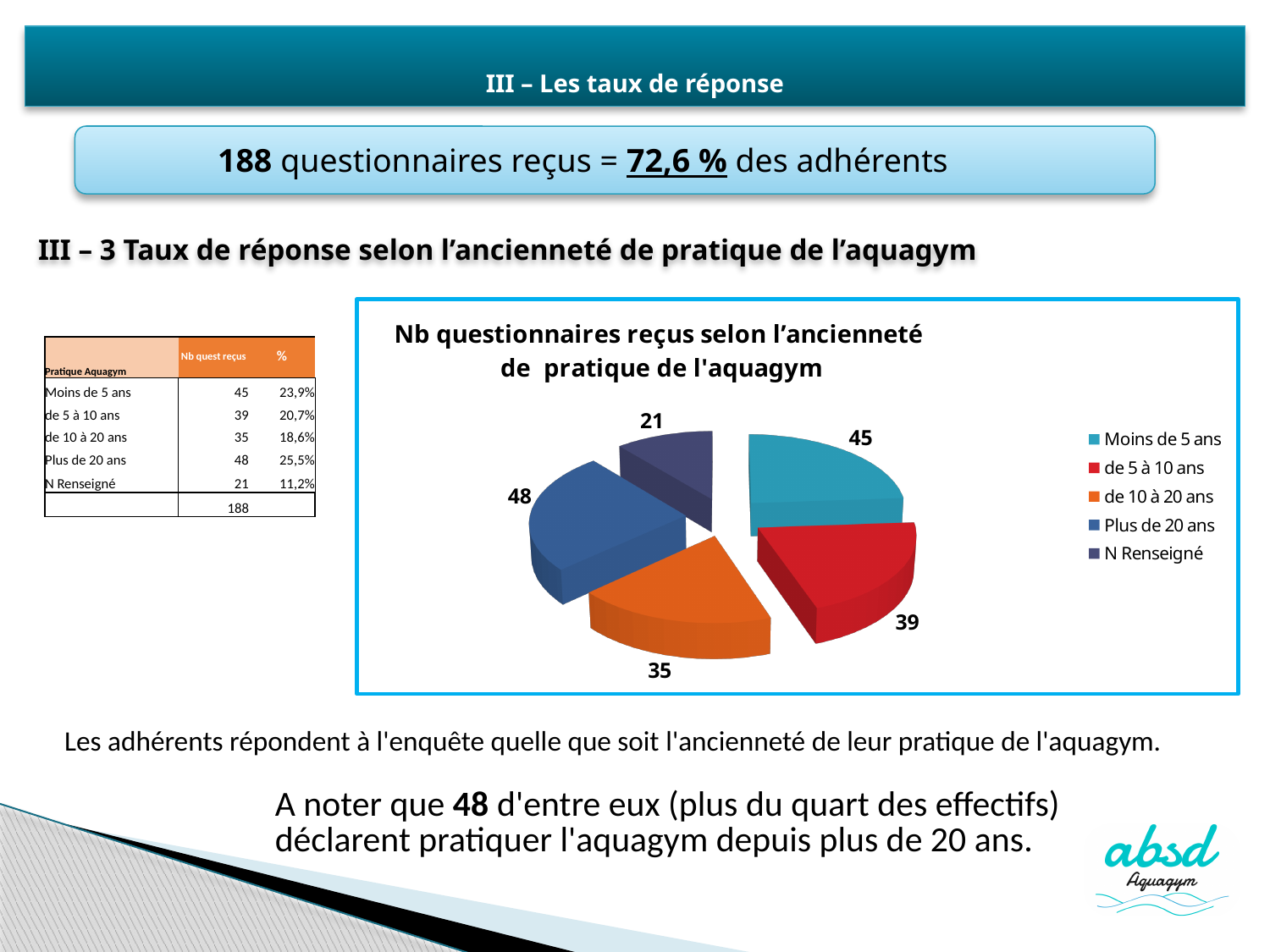
What is the value for 'Moins de 5 ans' in the pie chart? 45 What is the total of all the values shown in the pie chart? 188 Which category has the smallest slice in the pie chart? N Renseigné What kind of chart is shown on the slide? pie chart How many entries does the legend of the pie chart list? 5 How many slices does the pie chart have? 5 What is the value for 'N Renseigné' in the pie chart? 21 What is the title of the pie chart? Nb questionnaires reçus selon l'ancienneté de pratique de l'aquagym Which category has the largest slice in the pie chart? Plus de 20 ans What is the value for 'Plus de 20 ans' in the pie chart? 48 What is the difference between the values for 'Plus de 20 ans' and 'N Renseigné'? 27 Which is larger, the value for 'de 5 à 10 ans' or 'de 10 à 20 ans'? de 5 à 10 ans